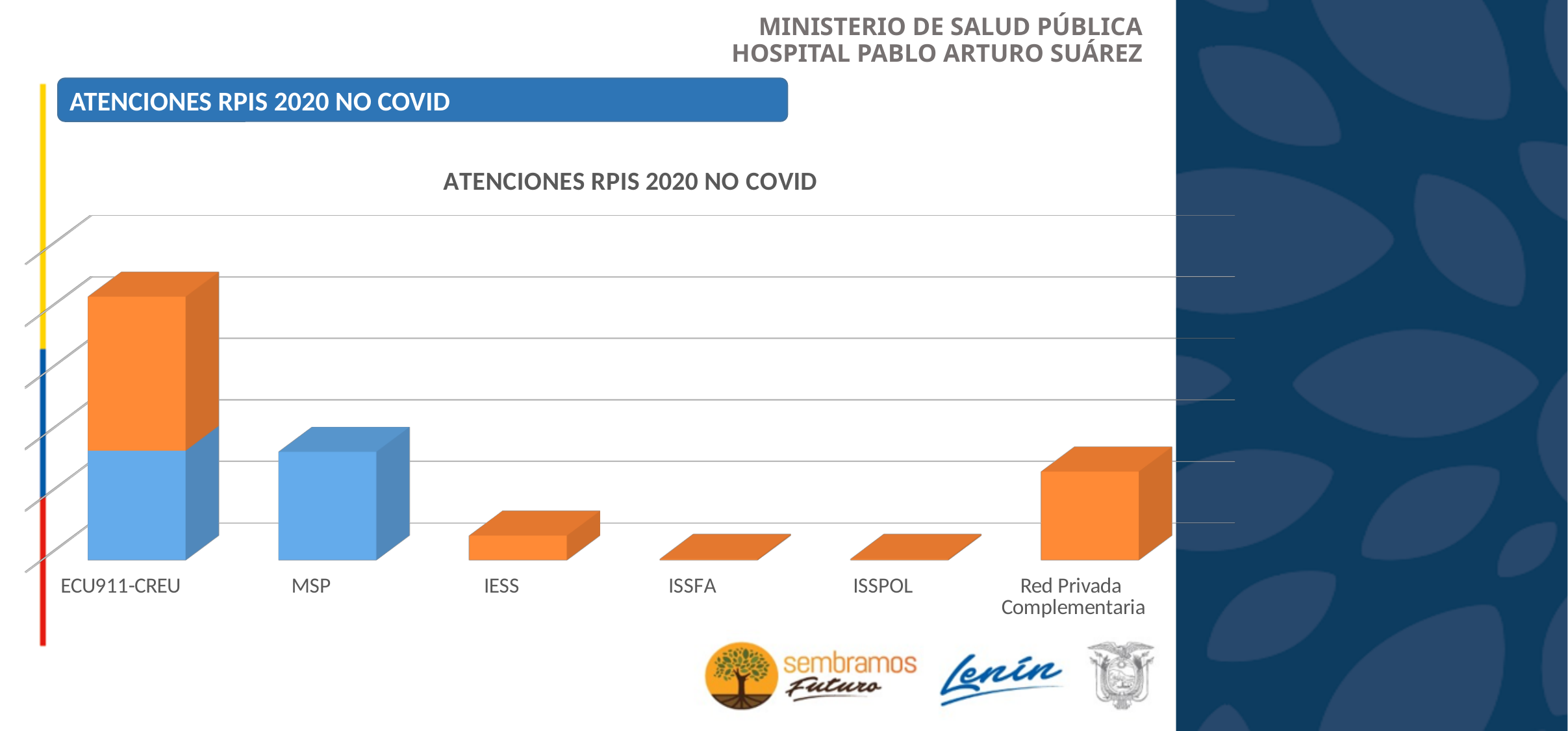
Which category is the last one on the x axis of the chart? Red Privada Complementaria Which bar is taller, Red Privada Complementaria or IESS? Red Privada Complementaria Which category has the tallest bar in the chart? ECU911-CREU Which bar is taller, IESS or ISSFA? IESS What is the title of the chart? ATENCIONES RPIS 2020 NO COVID Which bar is taller, ECU911-CREU or Red Privada Complementaria? ECU911-CREU How many categories are shown on the x axis of the chart? 6 What kind of chart is shown on the slide? bar chart